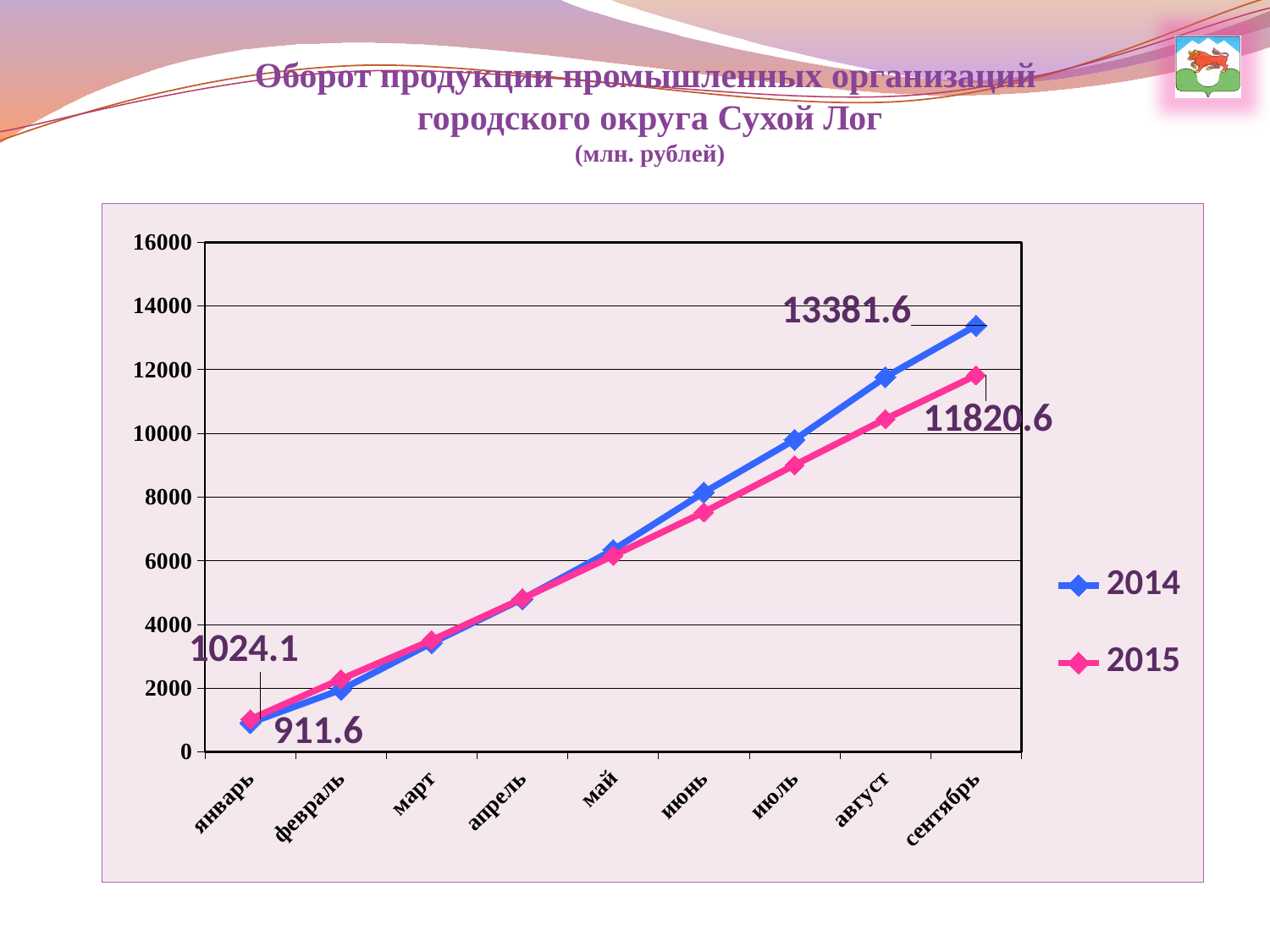
Is the value for 2015 in август greater or less than 10000? greater How many months are shown on the x axis? 9 What is the value for 2014 in январь? 911.6 What is the value for 2014 in сентябрь? 13381.6 Which series has the larger value in сентябрь, 2014 or 2015? 2014 How many series does the legend list? 2 What is the value for 2015 in сентябрь? 11820.6 Is the value for 2014 in июль greater or less than 10000? less What is the value for 2015 in январь? 1024.1 What kind of chart is shown on the slide? line chart Do the values for 2014 rise or fall from январь to сентябрь? rise What is the difference between the 2014 and 2015 values in сентябрь? 1561.0